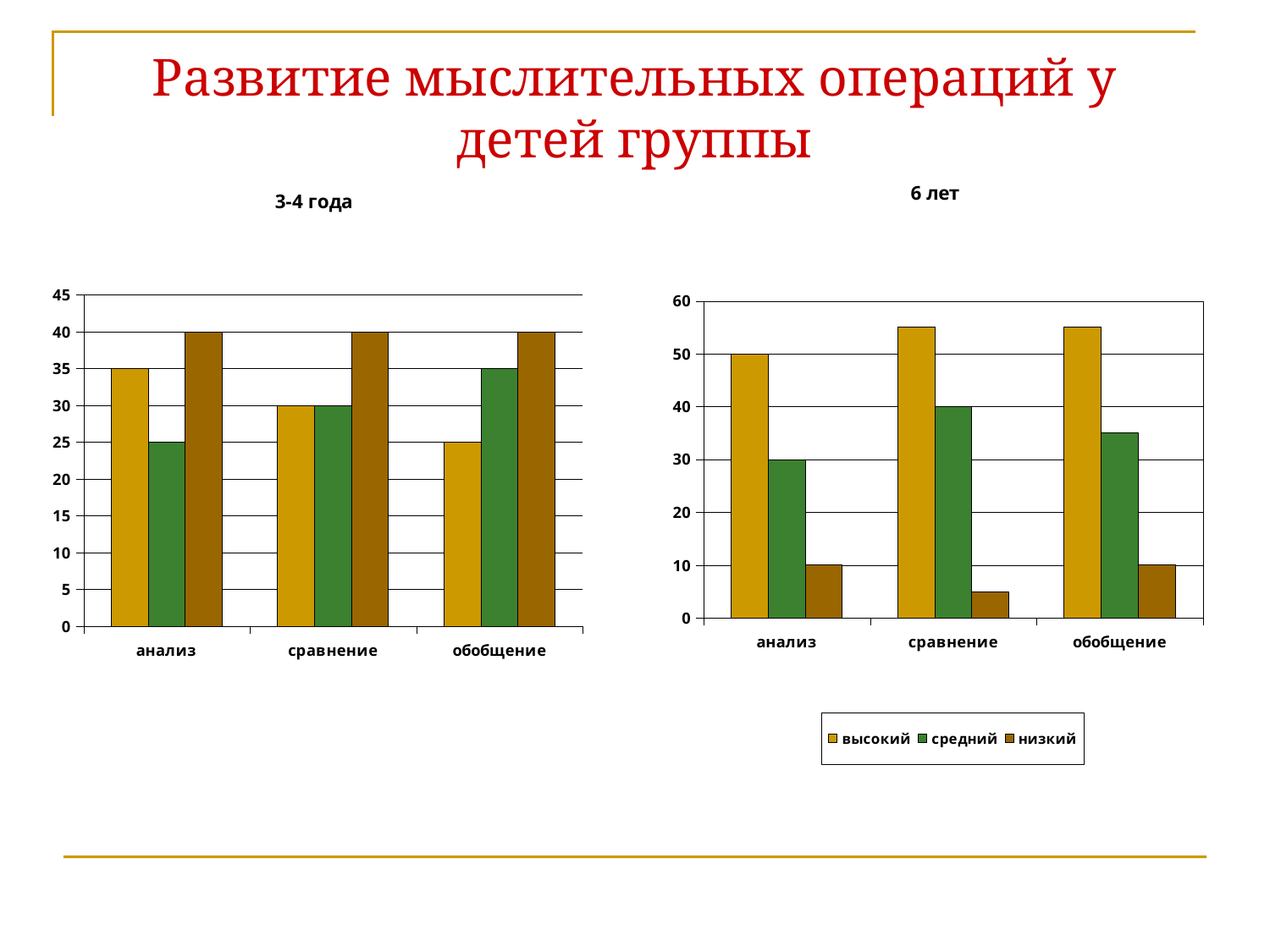
How many series does the legend on the slide list? 3 In the "6 лет" chart, what is the value of the средний bar for сравнение? 40 In the "6 лет" chart, what is the value of the высокий bar for анализ? 50 In the "3-4 года" chart, what is the difference between the низкий and высокий bars for обобщение? 15 How many categories are shown on the x axis of the "6 лет" chart? 3 What type of chart is the "3-4 года" chart? bar chart In the "3-4 года" chart, what is the value of the средний (green) bar for обобщение? 35 In the "3-4 года" chart, what is the value of the низкий (brown) bar for сравнение? 40 In the "6 лет" chart, which is larger for анализ: the средний bar or the низкий bar? средний In the "6 лет" chart, is the высокий bar for сравнение greater or less than 50? greater In the "6 лет" chart, which category has the lowest низкий bar? сравнение In the "3-4 года" chart, what is the value of the высокий (yellow) bar for анализ? 35